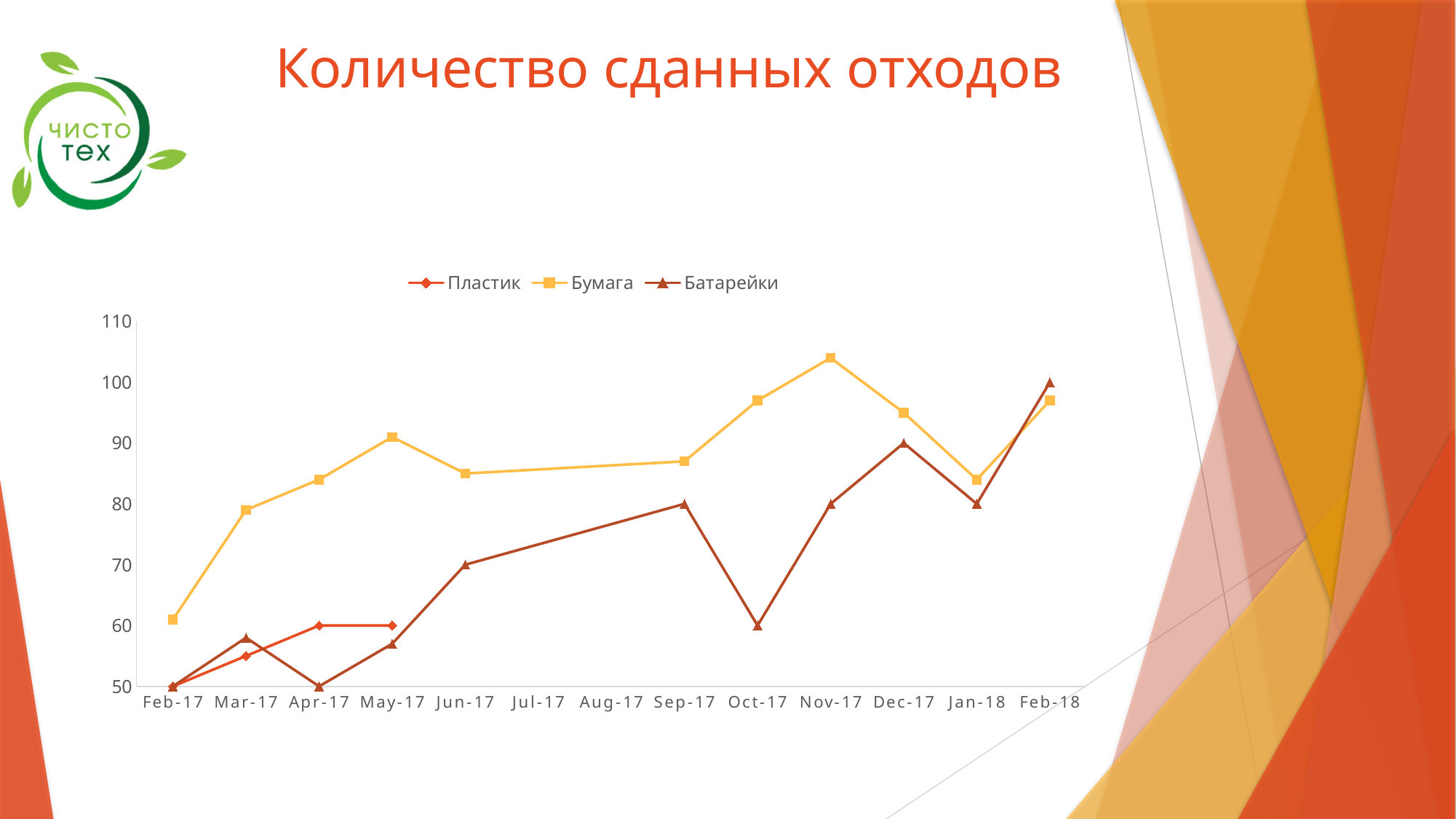
What is the difference between the Батарейки values in Feb-18 and Oct-17? 40 What is the value for Батарейки in Oct-17? 60 How many series does the legend list? 3 Is the value for Бумага in Nov-17 greater or less than 100? greater In which month does Бумага reach its highest value? Nov-17 What is the value for Батарейки in Dec-17? 90 How many months are shown on the x axis? 13 What is the value for Пластик in Apr-17? 60 What is the value for Батарейки in Feb-18? 100 In Oct-17, which series has the larger value, Бумага or Батарейки? Бумага Is the value for Бумага in Feb-17 greater or less than 70? less What kind of chart is shown on the slide? line chart